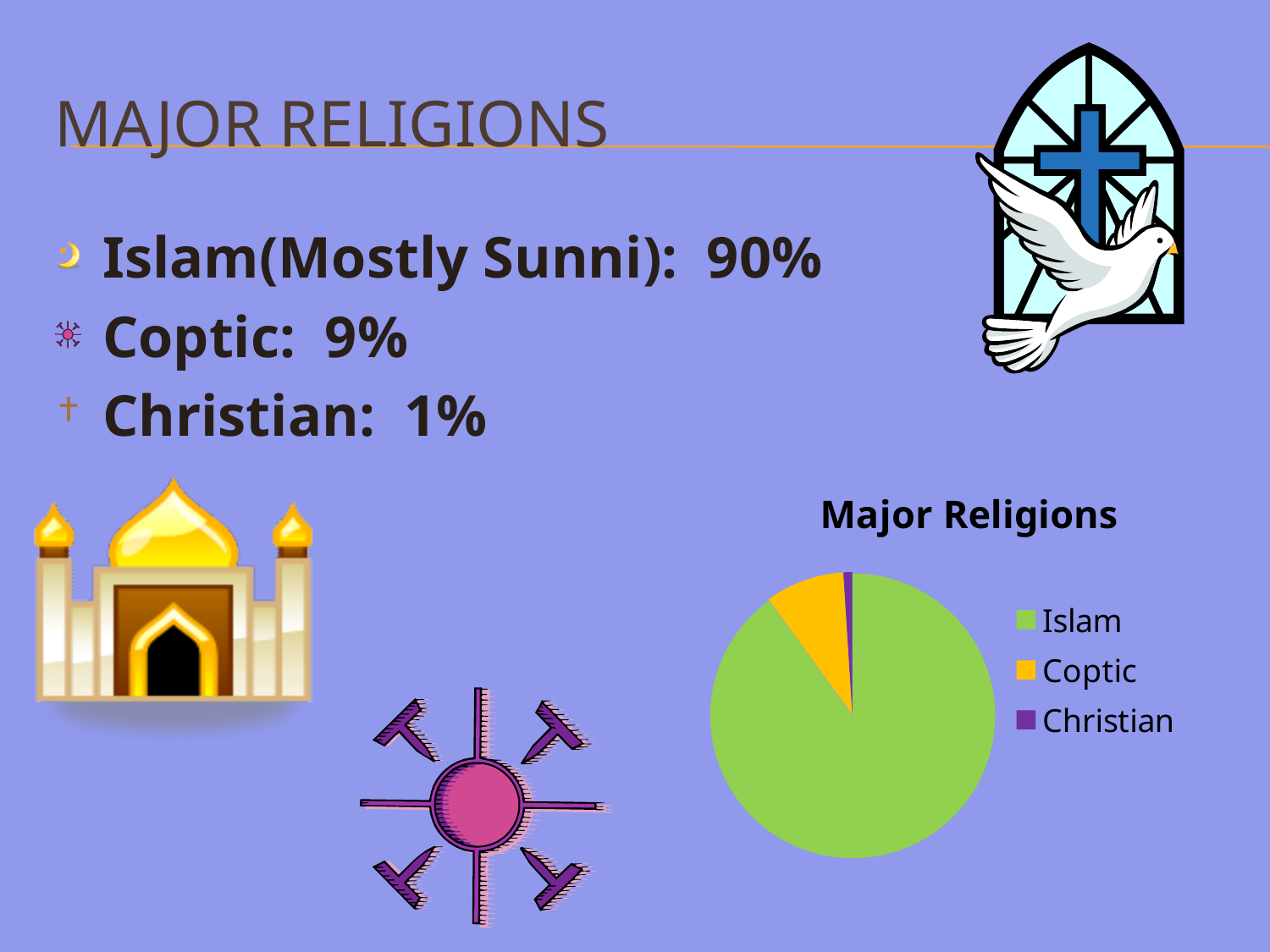
What is the title of the chart? Major Religions What kind of chart is shown on the slide? pie chart What colour is the Coptic slice in the pie chart? orange What share of the pie does Christian represent? 1% Which religion has the smallest slice in the pie chart? Christian What share of the pie does Coptic represent? 9% What share of the pie does Islam represent? 90% How many entries does the chart legend list? 3 Which slice is larger in the pie chart, Coptic or Christian? Coptic What is the difference between the Islam share and the Coptic share? 81% Which religion has the largest slice in the pie chart? Islam How many slices does the pie chart have? 3